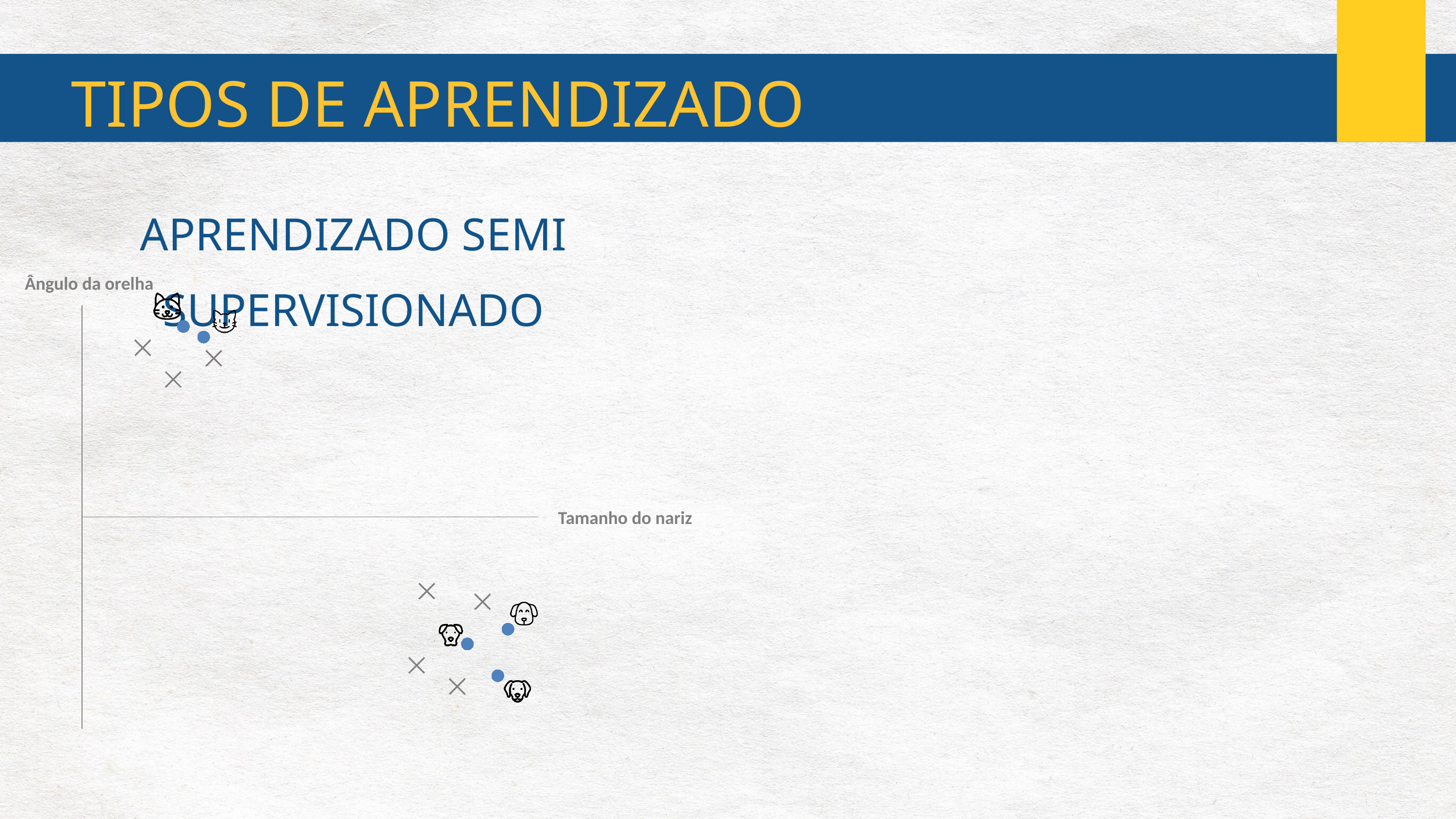
Which cluster is plotted further along the Tamanho do nariz axis, the cat cluster or the dog cluster? The dog cluster How many X marks are plotted on the chart in total? 7 What kind of chart is shown on the slide? Scatter plot What is the label of the horizontal axis of the chart? Tamanho do nariz How many separate clusters of points are plotted on the chart? 2 How many blue dots are in the cluster marked with dog icons? 3 What is the label of the vertical axis of the chart? Ângulo da orelha Which cluster is plotted higher on the Ângulo da orelha axis, the cat cluster or the dog cluster? The cat cluster